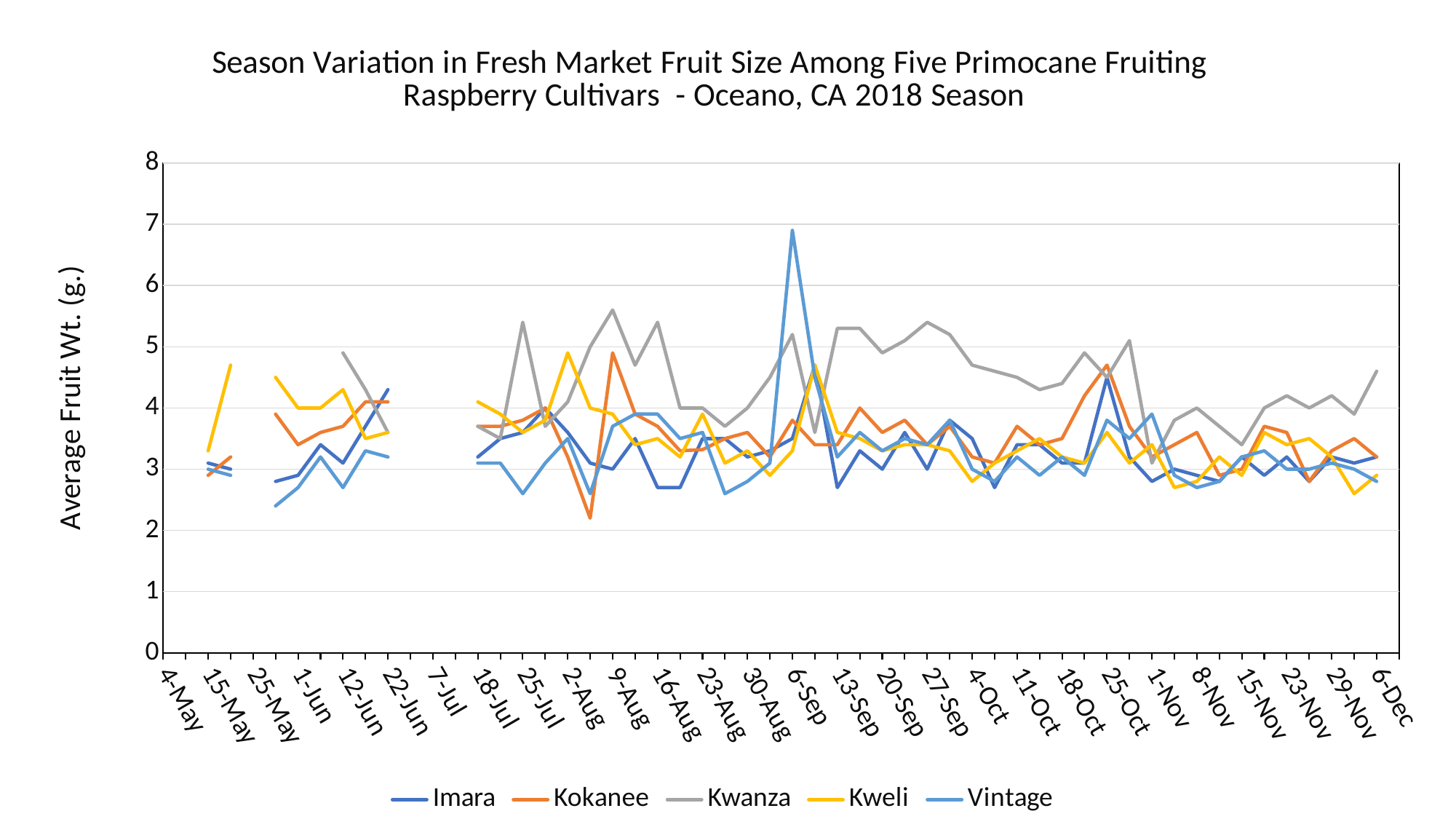
How many cultivars (series) does the legend list? 5 At 6-Sep, which is higher: Vintage or Kwanza? Vintage Which cultivar has the lowest value at 2-Aug? Kokanee Is the value for Kwanza at 6-Dec greater or less than 4? greater Is the value for Kwanza at 9-Aug greater or less than 5? greater Which cultivars are listed in the legend? Imara, Kokanee, Kwanza, Kweli, Vintage Which cultivar reaches the single highest value on the chart? Vintage Is the peak value for Vintage around 6-Sep greater or less than 6? greater What kind of chart is shown on the slide? line chart What is the label on the vertical axis? Average Fruit Wt. (g.) Which cultivar has the highest value at 27-Sep? Kwanza